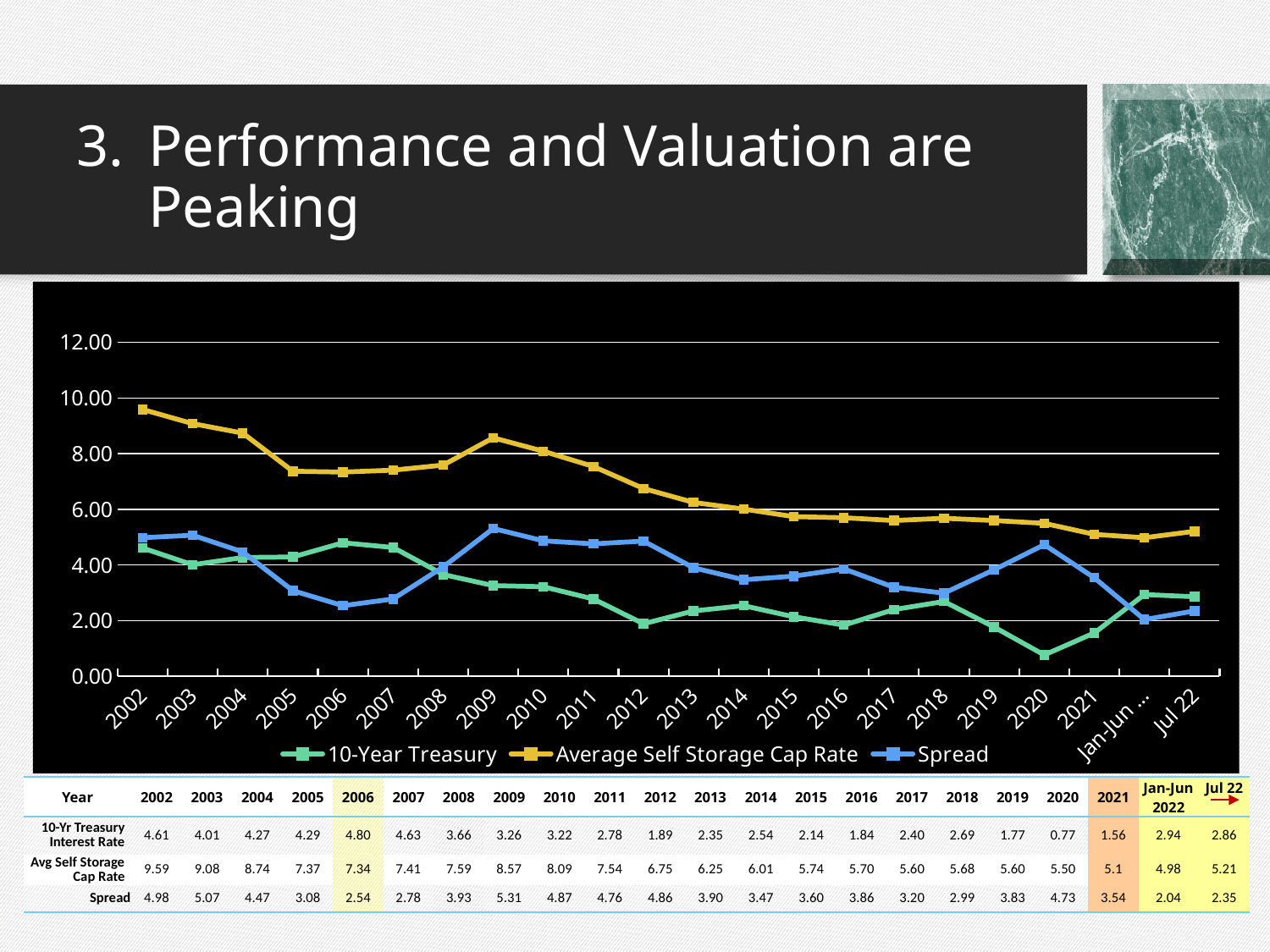
How many series does the chart legend list? 3 What is the Average Self Storage Cap Rate value for 2009? 8.57 How many time periods are plotted along the x axis of the chart? 22 What is the difference between the Average Self Storage Cap Rate in 2002 and in 2020? 4.09 What is the 10-Year Treasury value for 2020? 0.77 What type of chart is shown on the slide? line chart What is the Spread value for Jul 22? 2.35 Which is larger in 2012, the 10-Year Treasury or the Spread? Spread In which year does the Spread reach its highest value? 2009 Does the Average Self Storage Cap Rate generally rise or fall from 2002 to Jul 22? fall In which year is the Average Self Storage Cap Rate highest? 2002 In which period is the 10-Year Treasury value lowest? 2020